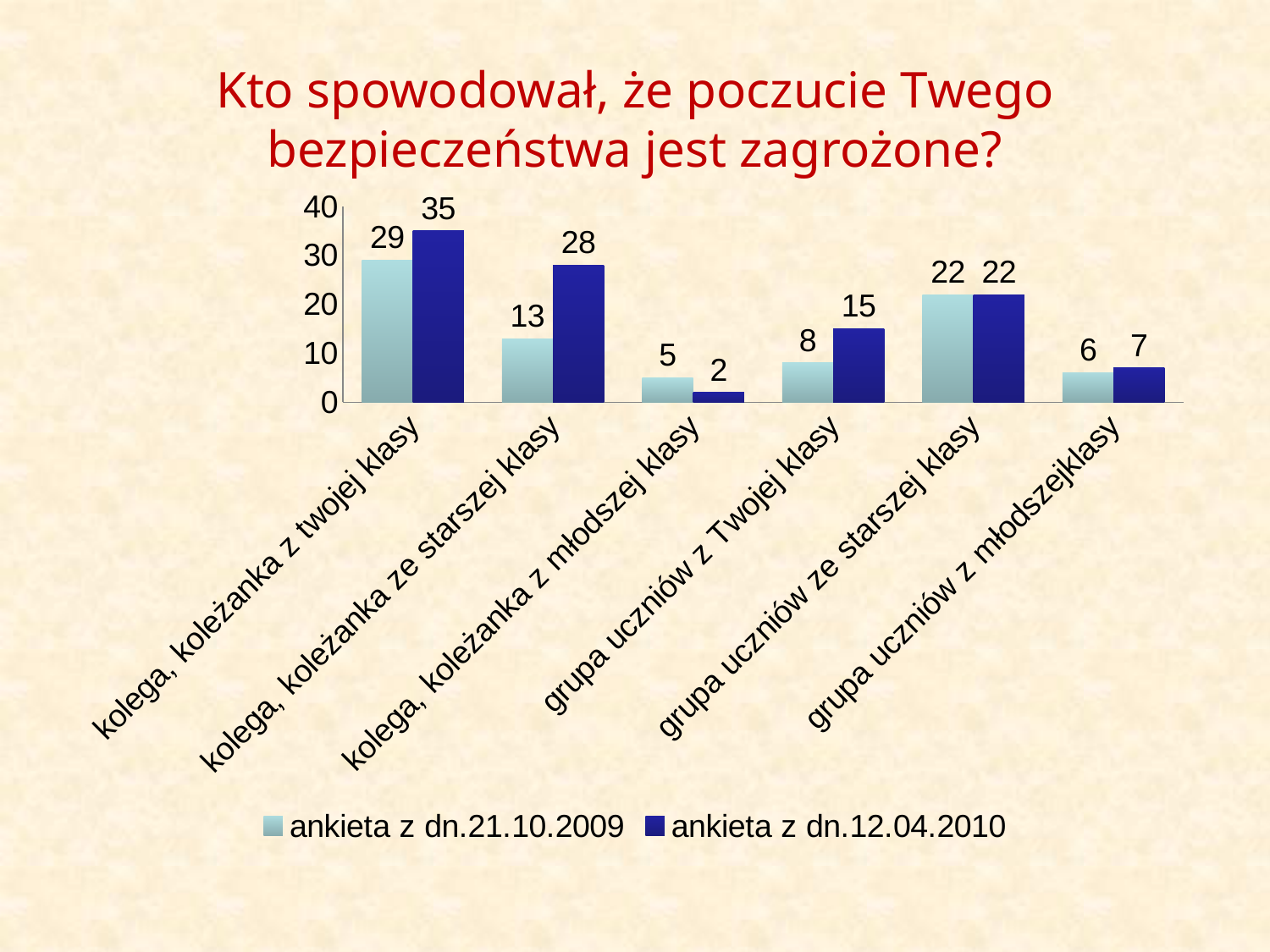
What kind of chart is shown on the slide? bar chart What is the value for 'grupa uczniów ze starszej klasy' in both series? 22 Which category has the lowest value in the 'ankieta z dn.12.04.2010' series? kolega, koleżanka z młodszej klasy What is the value for 'grupa uczniów z Twojej klasy' in the 'ankieta z dn.12.04.2010' series? 15 How many series does the legend list? 2 Is the value for 'kolega, koleżanka z twojej klasy' in the 'ankieta z dn.21.10.2009' series greater or less than 20? greater Which category has the highest value in the 'ankieta z dn.21.10.2009' series? kolega, koleżanka z twojej klasy What is the value for 'kolega, koleżanka z twojej klasy' in the 'ankieta z dn.12.04.2010' series? 35 What is the value for 'kolega, koleżanka ze starszej klasy' in the 'ankieta z dn.21.10.2009' series? 13 What is the difference between the two series for 'kolega, koleżanka ze starszej klasy'? 15 How many categories are shown on the x axis? 6 For 'kolega, koleżanka z młodszej klasy', which series has the larger value? ankieta z dn.21.10.2009